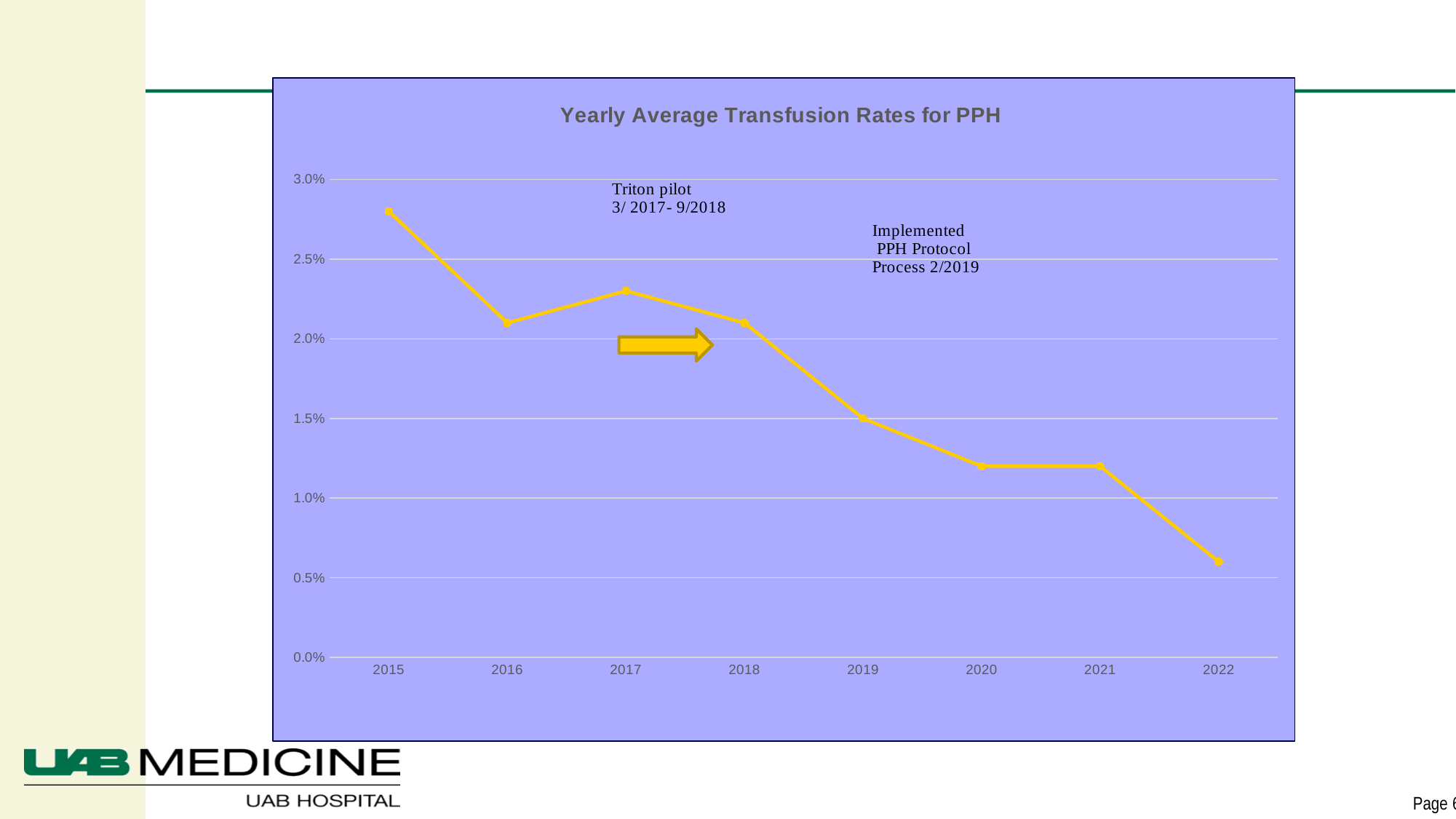
Is the transfusion rate for 2022 greater or less than 1.0%? less Which year has the highest transfusion rate? 2015 What is the title of the chart? Yearly Average Transfusion Rates for PPH Which year has the lowest transfusion rate? 2022 Is the transfusion rate for 2015 greater or less than 2.5%? greater How many years are plotted on the x axis of the chart? 8 What kind of chart is shown on the slide? line chart What is the transfusion rate for 2019? 1.5% Which year has a higher transfusion rate, 2017 or 2018? 2017 Overall, do the transfusion rates rise or fall from 2015 to 2022? fall Is the transfusion rate for 2017 greater or less than 2.0%? greater